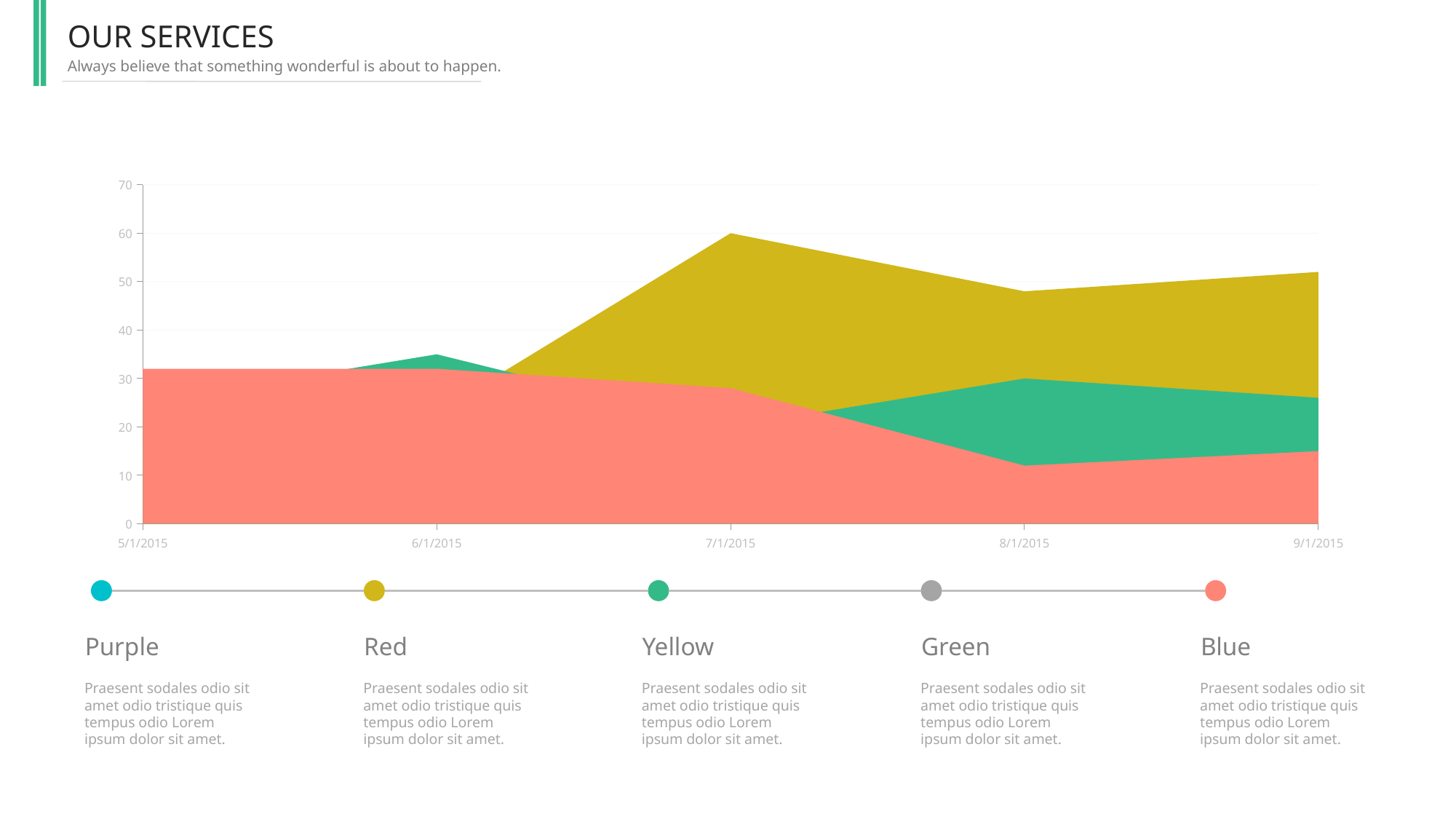
Is the value of the yellow area at 8/1/2015 greater or less than 40? greater What is the last date shown on the x axis of the chart? 9/1/2015 At 9/1/2015, which is larger: the yellow area or the green area? the yellow area Is the value of the red area at 8/1/2015 greater or less than 20? less Does the red area rise or fall from 6/1/2015 to 8/1/2015? fall Is the value of the green area at 8/1/2015 greater or less than 20? greater How many dates are labelled along the x axis of the chart? 5 What is the first date shown on the x axis of the chart? 5/1/2015 At which date does the yellow area reach its highest point? 7/1/2015 What kind of chart is shown on the slide? area chart At which date does the red area reach its lowest point? 8/1/2015